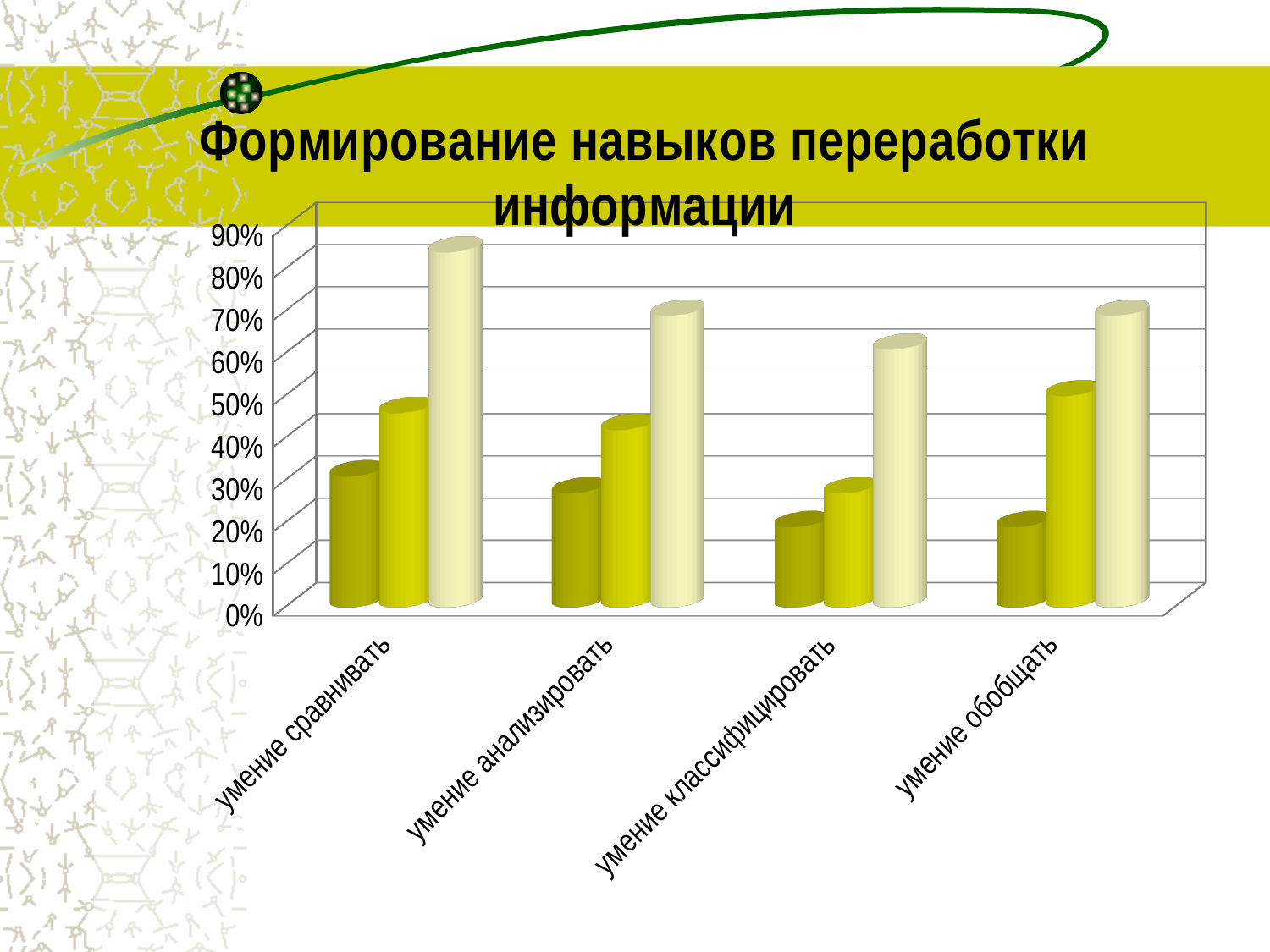
Is the lightest (pale) bar for умение сравнивать greater or less than 80%? greater Which category has the larger middle (yellow) bar: умение обобщать or умение классифицировать? умение обобщать For which category is the lightest (pale) bar the highest? умение сравнивать Is the darkest (olive) bar for умение классифицировать greater or less than 30%? less What kind of chart is shown on the slide? bar chart Is the middle (yellow) bar for умение обобщать greater or less than 40%? greater What is the title of the slide above the chart? Формирование навыков переработки информации How many bars are shown for each category in the chart? 3 For which category is the lightest (pale) bar the lowest? умение классифицировать How many categories are shown on the x axis of the chart? 4 Which category has the larger lightest (pale) bar: умение сравнивать or умение анализировать? умение сравнивать